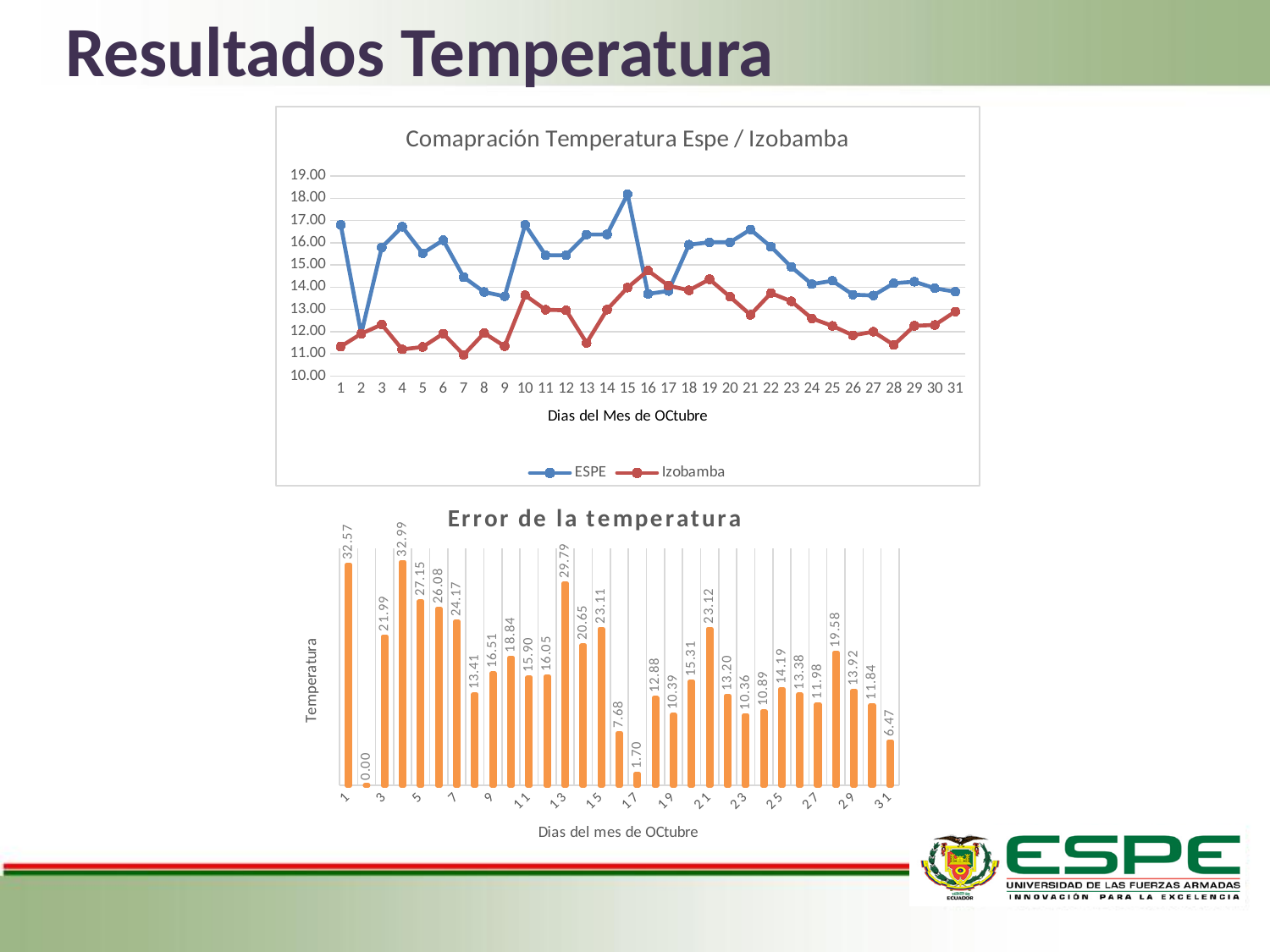
In the top chart, is the ESPE value on day 15 greater or less than 18.00? greater In the 'Error de la temperatura' chart, which day has the highest value? 4 In the 'Error de la temperatura' chart, what is the value for day 13? 29.79 In the top chart, which series is higher on day 1, ESPE or Izobamba? ESPE In the top chart, how many series does the legend list? 2 In the top chart, what is the x-axis title? Dias del Mes de OCtubre In the 'Error de la temperatura' chart, how many days are plotted? 31 In the 'Error de la temperatura' chart, which day has the lowest value? 2 In the top chart, what type of chart is used to compare the ESPE and Izobamba temperatures? line chart In the 'Error de la temperatura' chart, what is the difference between the values for day 4 and day 31? 26.52 In the 'Error de la temperatura' chart, what is the value for day 1? 32.57